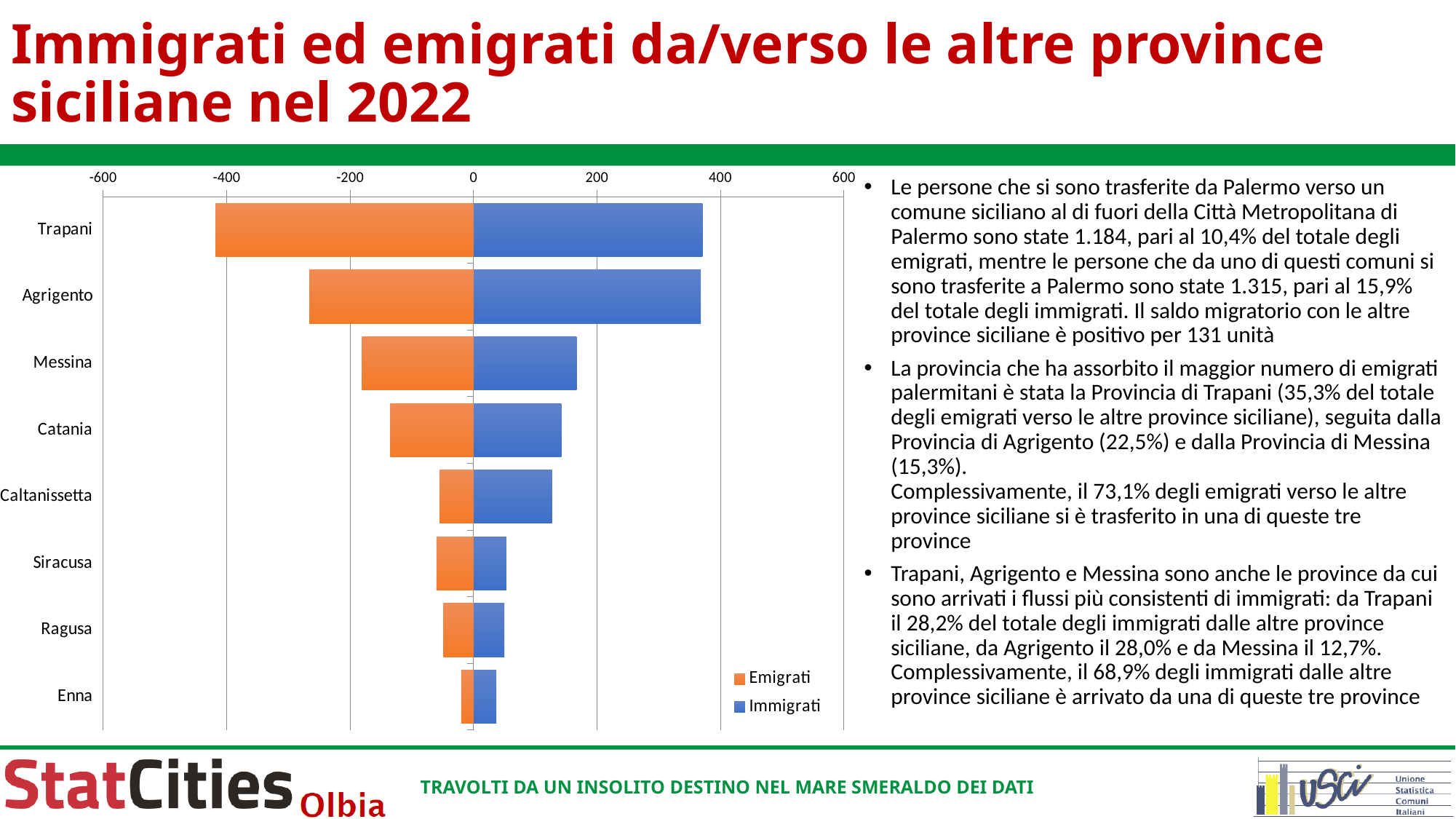
What are the two series named in the chart legend? Emigrati and Immigrati What kind of chart is shown on the slide? bar chart Which province has the larger Immigrati bar, Messina or Catania? Messina Is the Immigrati value for Trapani greater or less than 200? greater Which province has the shortest Immigrati bar in the chart? Enna How many series does the chart legend list? 2 Going down the chart from Trapani to Enna, do the bar lengths increase or decrease? decrease Which province has the longest Emigrati bar in the chart? Trapani Is the Immigrati value for Messina greater or less than 200? less Which colour represents the Emigrati series in the chart? orange Is the Emigrati bar for Trapani extending beyond -400 on the axis, i.e. is its value less than -400? less How many provinces are listed on the vertical axis of the chart? 8